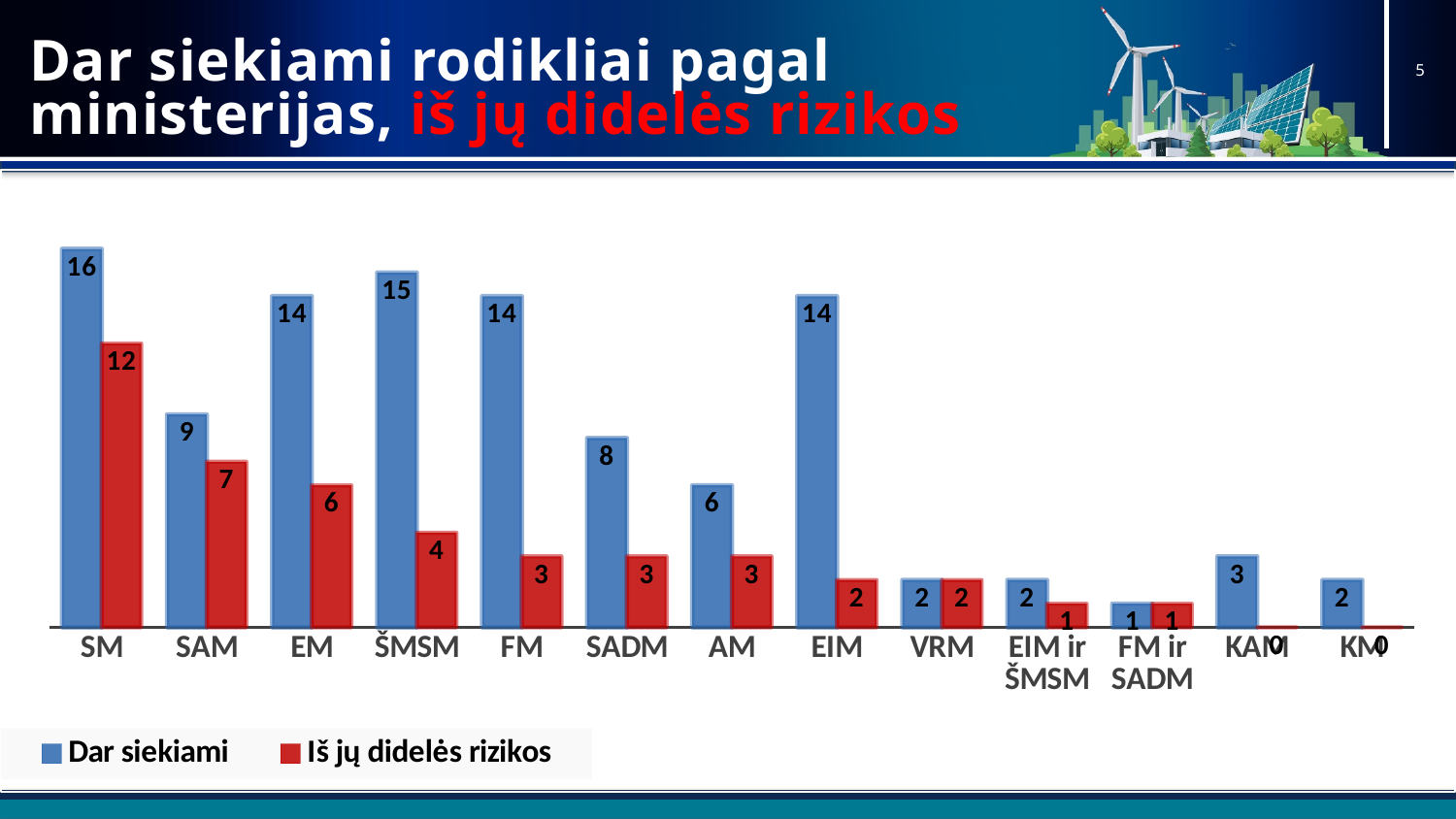
What is the 'Dar siekiami' value for SM? 16 How many series does the legend list? 2 What type of chart is shown on the slide? bar chart Which is larger: the 'Dar siekiami' value for SAM or the 'Dar siekiami' value for AM? SAM Which series is shown in red in the legend? Iš jų didelės rizikos How many categories (ministries) are shown on the x axis? 13 What is the 'Iš jų didelės rizikos' value for KAM? 0 What is the difference between the 'Dar siekiami' and 'Iš jų didelės rizikos' values for EM? 8 Which category has the highest 'Dar siekiami' value? SM What is the 'Dar siekiami' value for SADM? 8 What is the 'Iš jų didelės rizikos' value for ŠMSM? 4 Which category has the lowest 'Dar siekiami' value? FM ir SADM